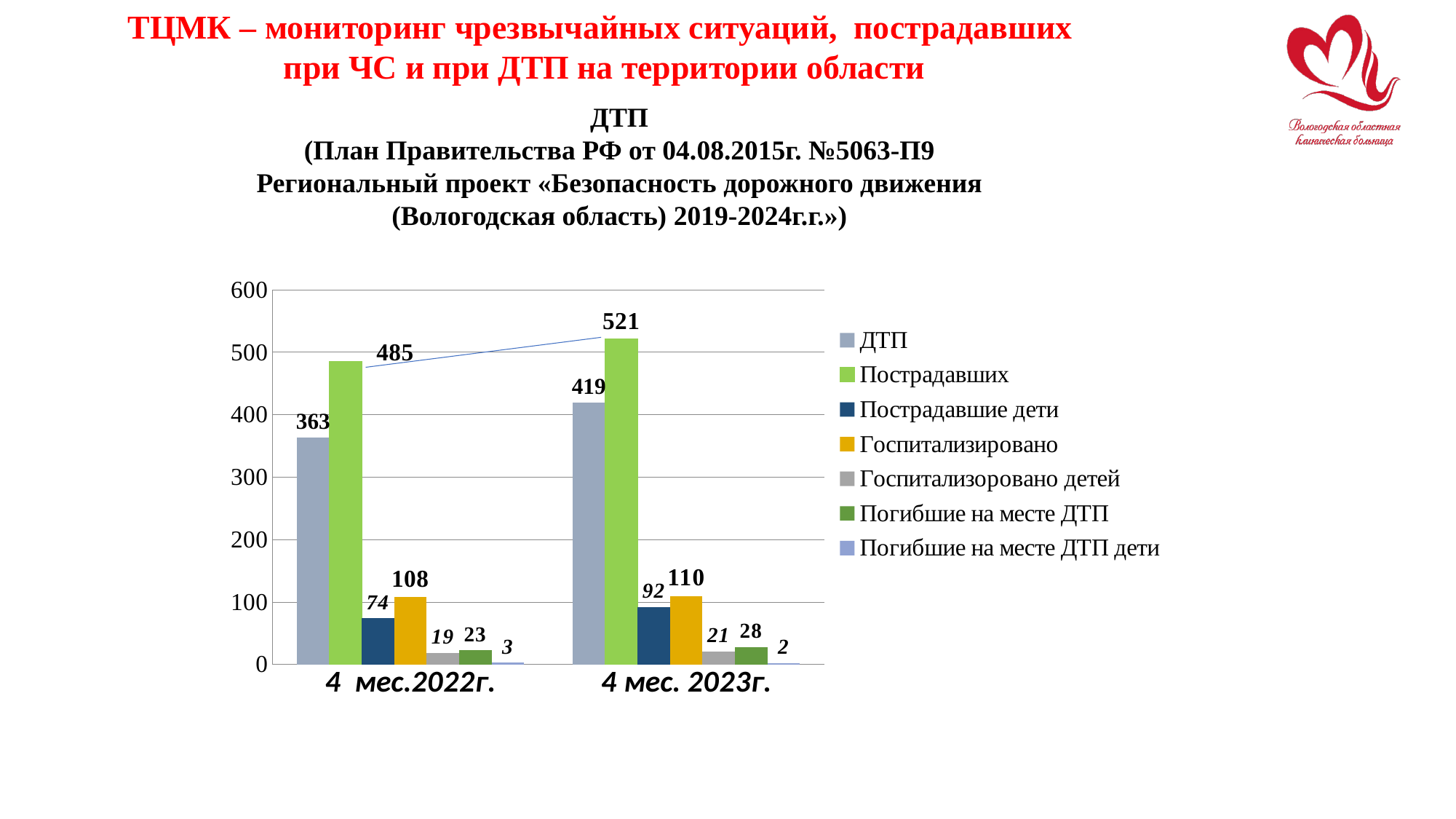
What is the value of Погибшие на месте ДТП дети for 4 мес.2022г.? 3 What is the value of ДТП for 4 мес.2022г.? 363 Which series has the highest value for 4 мес. 2023г.? Пострадавших What is the difference in ДТП between 4 мес. 2023г. and 4 мес.2022г.? 56 What is the value of Пострадавших for 4 мес. 2023г.? 521 What is the value of Госпитализировано for 4 мес. 2023г.? 110 Which series has the lowest value for 4 мес.2022г.? Погибшие на месте ДТП дети Which is larger: Пострадавшие дети for 4 мес.2022г. or for 4 мес. 2023г.? 4 мес. 2023г. How many categories are shown on the x axis? 2 What kind of chart is shown on the slide? Bar chart How many series does the legend list? 7 Does the value of Пострадавших rise or fall from 4 мес.2022г. to 4 мес. 2023г.? Rise